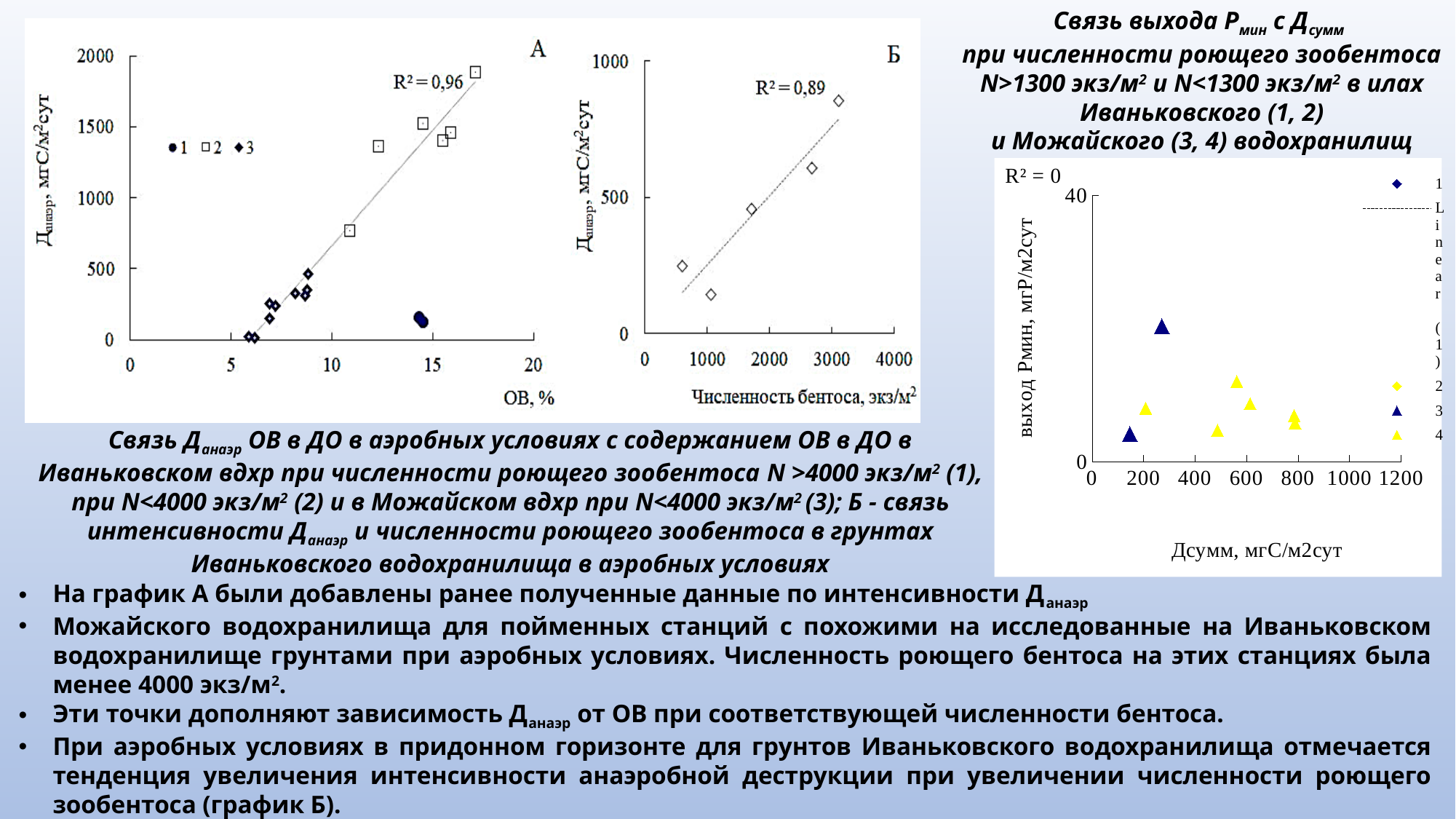
On chart Б, do the values of Данаэр rise or fall as the benthos abundance increases along the x axis? rise What kind of chart is chart A on the left of the slide? scatter chart What R² value is printed on chart A? R² = 0,96 On chart Б, is the value for the point at about 3000 экз/м² greater or less than 500? greater On the chart on the right of the slide (выход Рмин vs Дсумм), what R² value is printed? R² = 0 What R² value is printed on chart Б? R² = 0,89 On chart A, is the highest plotted value of series 2 greater or less than 1500? greater What is the x-axis label of the chart on the right of the slide (выход Рмин vs Дсумм)? Дсумм, мгС/м2сут How many series does the legend of chart A list? 3 What is the x-axis label of chart A? ОВ, % How many data points are plotted on chart Б? 5 On chart Б, is the value for the point at about 1000 экз/м² greater or less than 500? less